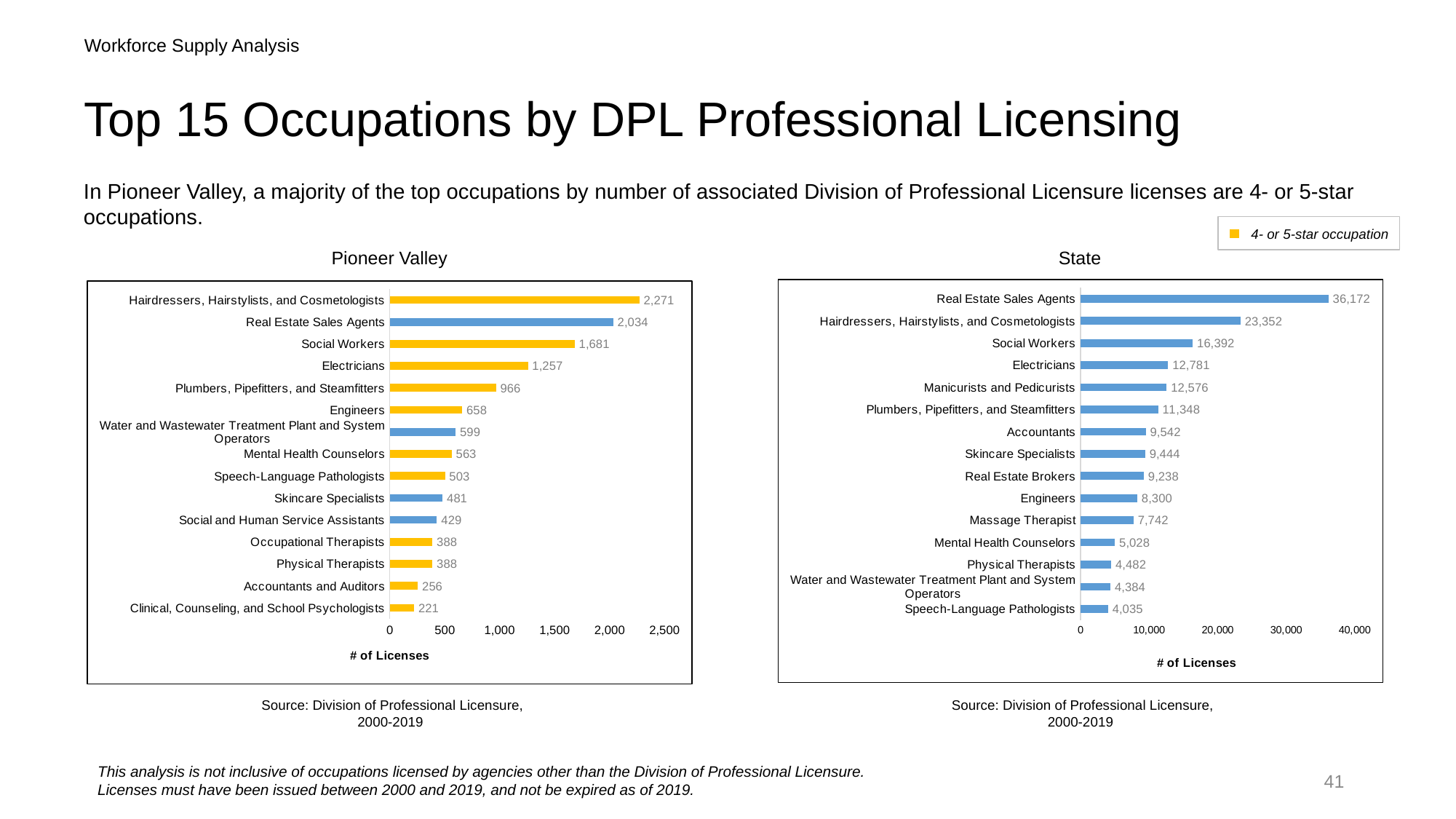
In the Pioneer Valley chart, what is the difference in licenses between Hairdressers, Hairstylists, and Cosmetologists and Real Estate Sales Agents? 237 In the State chart, which occupation has the most licenses? Real Estate Sales Agents What type of chart is the State chart? Bar chart In the Pioneer Valley chart, which has more licenses: Engineers or Mental Health Counselors? Engineers In the State chart, how many licenses are shown for Real Estate Sales Agents? 36,172 In the State chart, what is the difference in licenses between Social Workers and Electricians? 3,611 In the State chart, how many licenses are shown for Speech-Language Pathologists? 4,035 In the Pioneer Valley chart, how many licenses are shown for Hairdressers, Hairstylists, and Cosmetologists? 2,271 In the State chart, which has more licenses: Accountants or Massage Therapist? Accountants In the Pioneer Valley chart, which occupation has the fewest licenses? Clinical, Counseling, and School Psychologists How many occupations are listed in the Pioneer Valley chart? 15 What does the yellow colour in the Pioneer Valley chart indicate, according to the legend? 4- or 5-star occupation